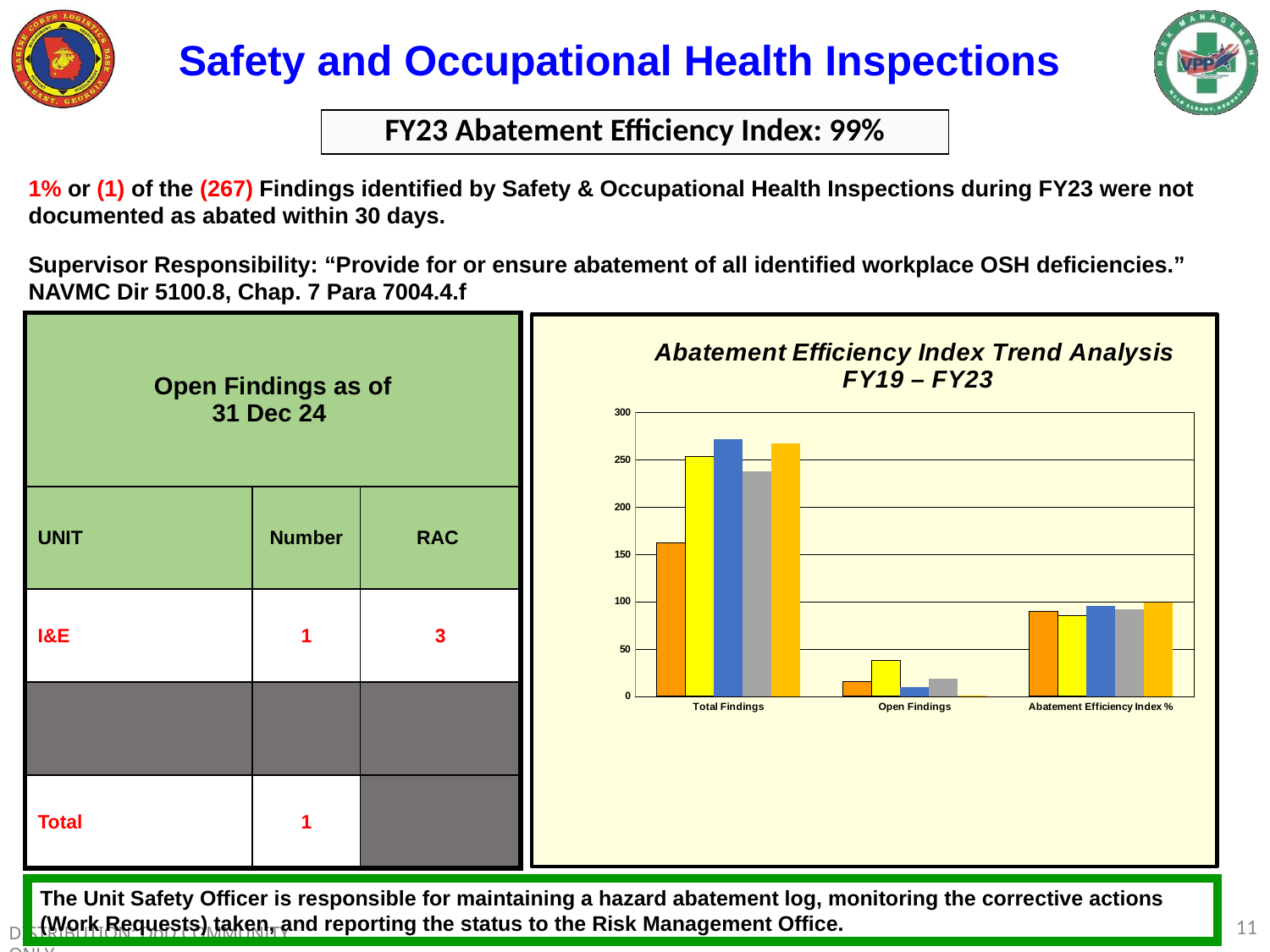
What is the highest value shown on the chart's vertical axis? 300 What kind of chart is shown on the slide? bar chart Which category on the x axis has the tallest bars overall? Total Findings Is the orange (first) bar in the Total Findings category greater or less than 200? less Which category on the x axis has the shortest bars overall? Open Findings How many categories are shown on the x axis of the chart? 3 What is the title of the chart on the slide? Abatement Efficiency Index Trend Analysis FY19 – FY23 How many bars are plotted in each category of the chart? 5 Which is larger: the yellow (second) bar for Total Findings or the yellow (second) bar for Open Findings? Total Findings Are the bars in the Abatement Efficiency Index % category greater or less than 150? less Is the tallest bar in the Open Findings category greater or less than 50? less